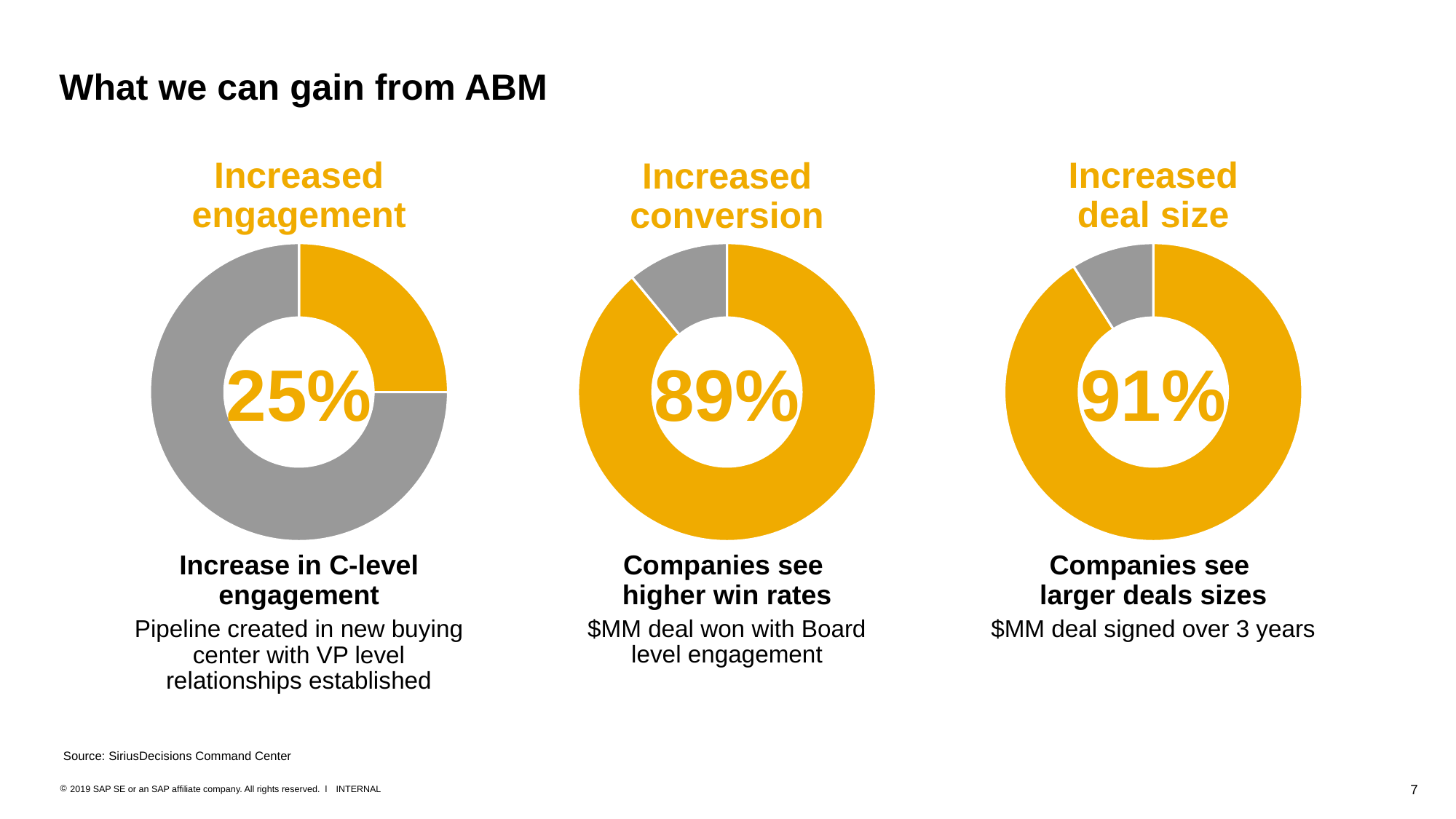
Which is larger: the percentage in the 'Increased engagement' chart or the percentage in the 'Increased conversion' chart? Increased conversion Across the three charts on the slide, which one shows the lowest percentage? Increased engagement In the 'Increased engagement' chart, what share of the donut is filled in yellow? 25% What colour is used for the highlighted (filled) portion of each donut chart? Yellow What is the difference in percentage points between the 'Increased deal size' chart and the 'Increased conversion' chart? 2 percentage points In the 'Increased engagement' chart, what percentage is shown in the centre of the donut? 25% In the 'Increased conversion' chart, what percentage is shown in the centre of the donut? 89% What is the difference in percentage points between the 'Increased conversion' chart and the 'Increased engagement' chart? 64 percentage points What kind of chart is used for each of the three figures on the slide? Donut (pie) chart In the 'Increased deal size' chart, what percentage is shown in the centre of the donut? 91% Across the three charts on the slide, which one shows the highest percentage? Increased deal size How many donut charts are shown on the slide? 3